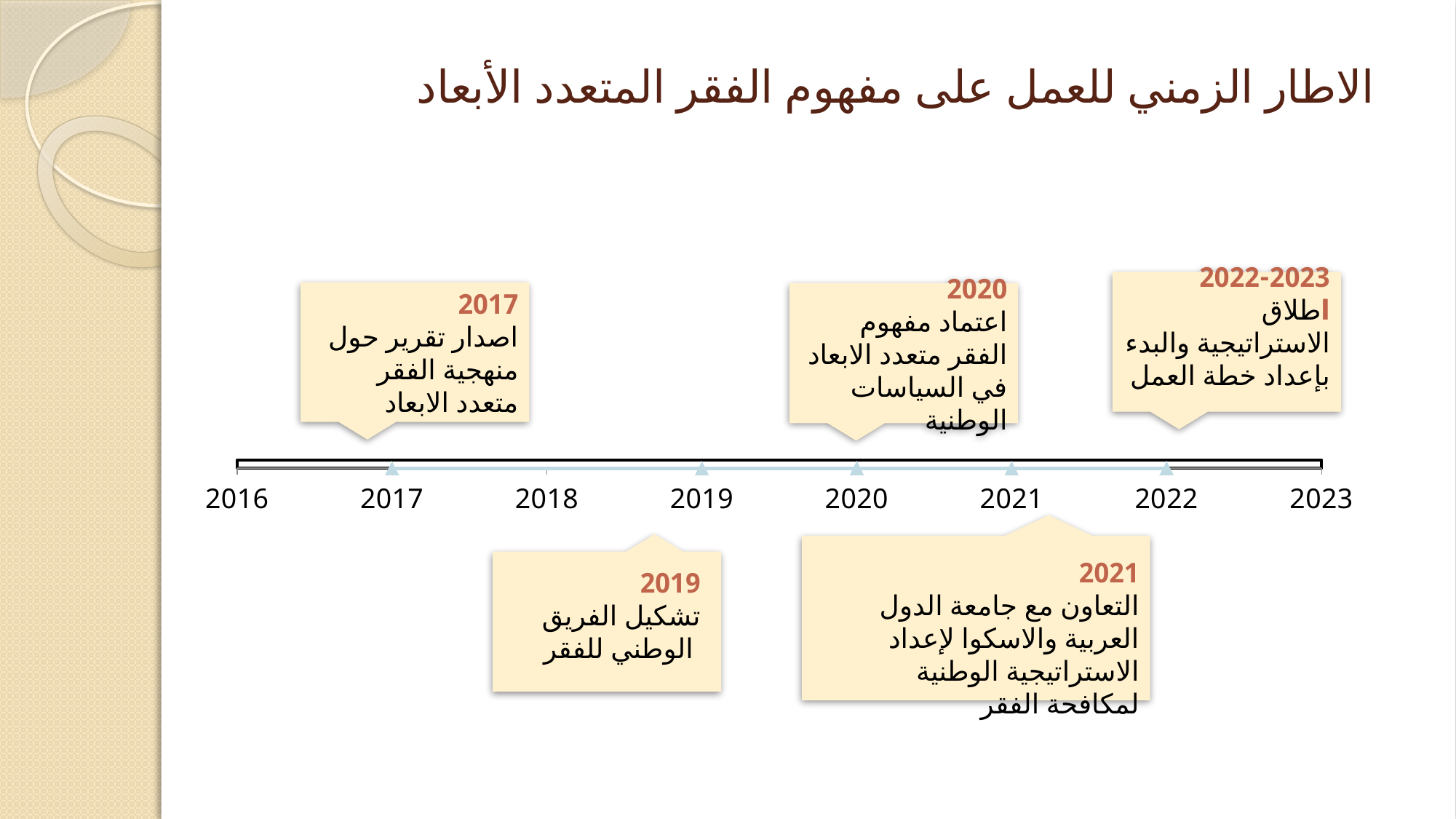
In which year was the national poverty team formed (تشكيل الفريق الوطني للفقر)? 2019 Which event comes earlier on the timeline: forming the national poverty team or adopting the multidimensional poverty concept in national policies? forming the national poverty team (2019) What is the first year shown on the timeline axis? 2016 What is the title of the timeline chart? الاطار الزمني للعمل على مفهوم الفقر المتعدد الأبعاد Which year is labelled on the callout about issuing a report on the multidimensional poverty methodology (اصدار تقرير حول منهجية الفقر متعدد الابعاد)? 2017 What period is labelled on the callout about launching the strategy and starting the action plan (اطلاق الاستراتيجية والبدء بإعداد خطة العمل)? 2022-2023 How many event callouts are placed on the timeline? 5 What kind of chart is shown on the slide? timeline How many year labels are shown along the timeline axis? 8 Which year is labelled on the callout about cooperation with the League of Arab States and ESCWA (التعاون مع جامعة الدول العربية والاسكوا)? 2021 In which year was the multidimensional poverty concept adopted in national policies (اعتماد مفهوم الفقر متعدد الابعاد في السياسات الوطنية)? 2020 What is the last year shown on the timeline axis? 2023